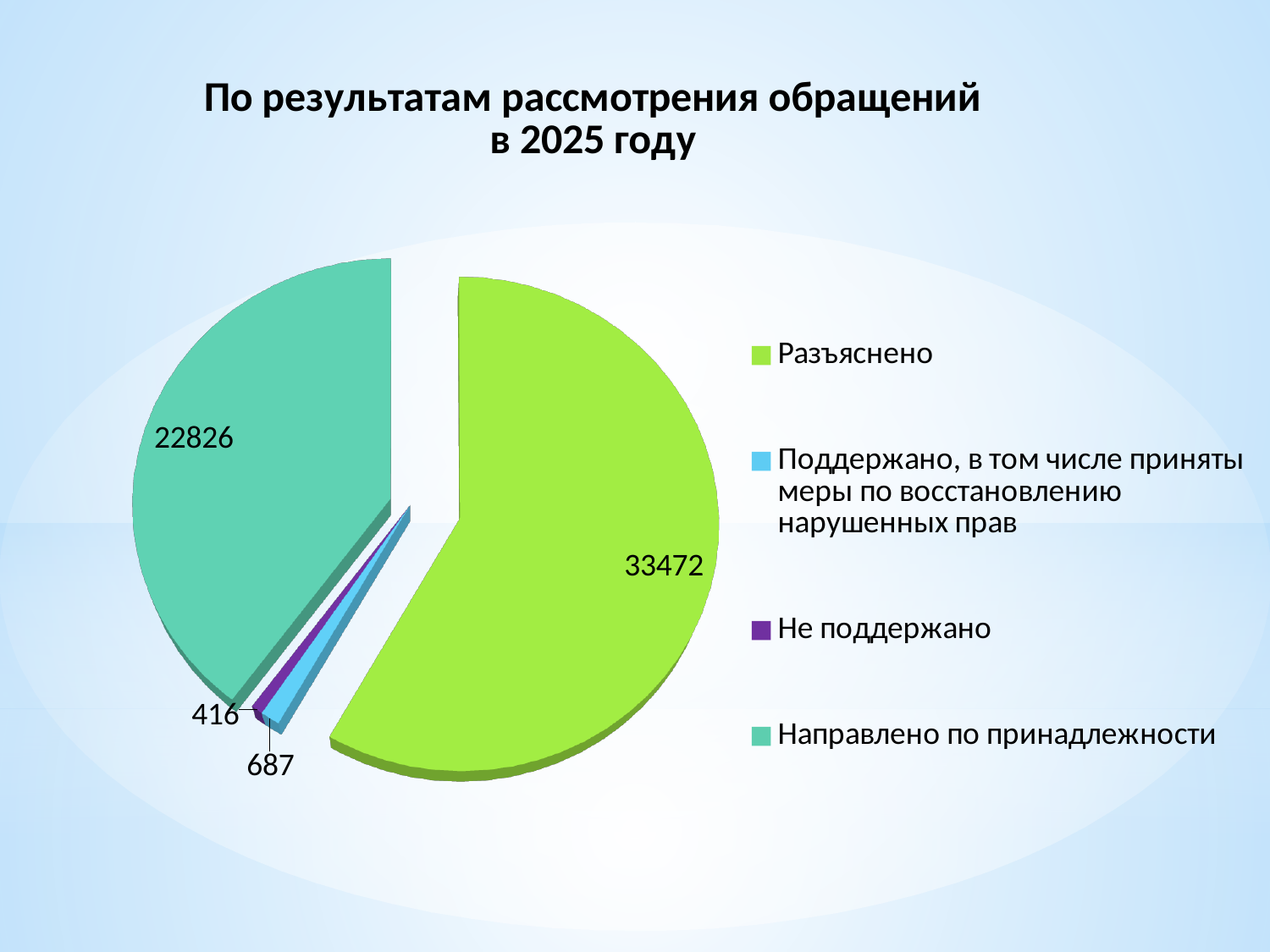
What is the difference between the values for Поддержано and Не поддержано? 271 How many categories does the legend list? 4 What is the value for Направлено по принадлежности? 22826 What is the value for Не поддержано? 416 What is the title of the chart? По результатам рассмотрения обращений в 2025 году What is the difference between the values for Разъяснено and Направлено по принадлежности? 10646 What is the value for Поддержано, в том числе приняты меры по восстановлению нарушенных прав? 687 Which category has the smallest slice of the pie? Не поддержано Which is larger, the value for Направлено по принадлежности or the value for Разъяснено? Разъяснено What type of chart is shown on the slide? Pie chart What is the value for Разъяснено? 33472 Which category has the largest slice of the pie? Разъяснено